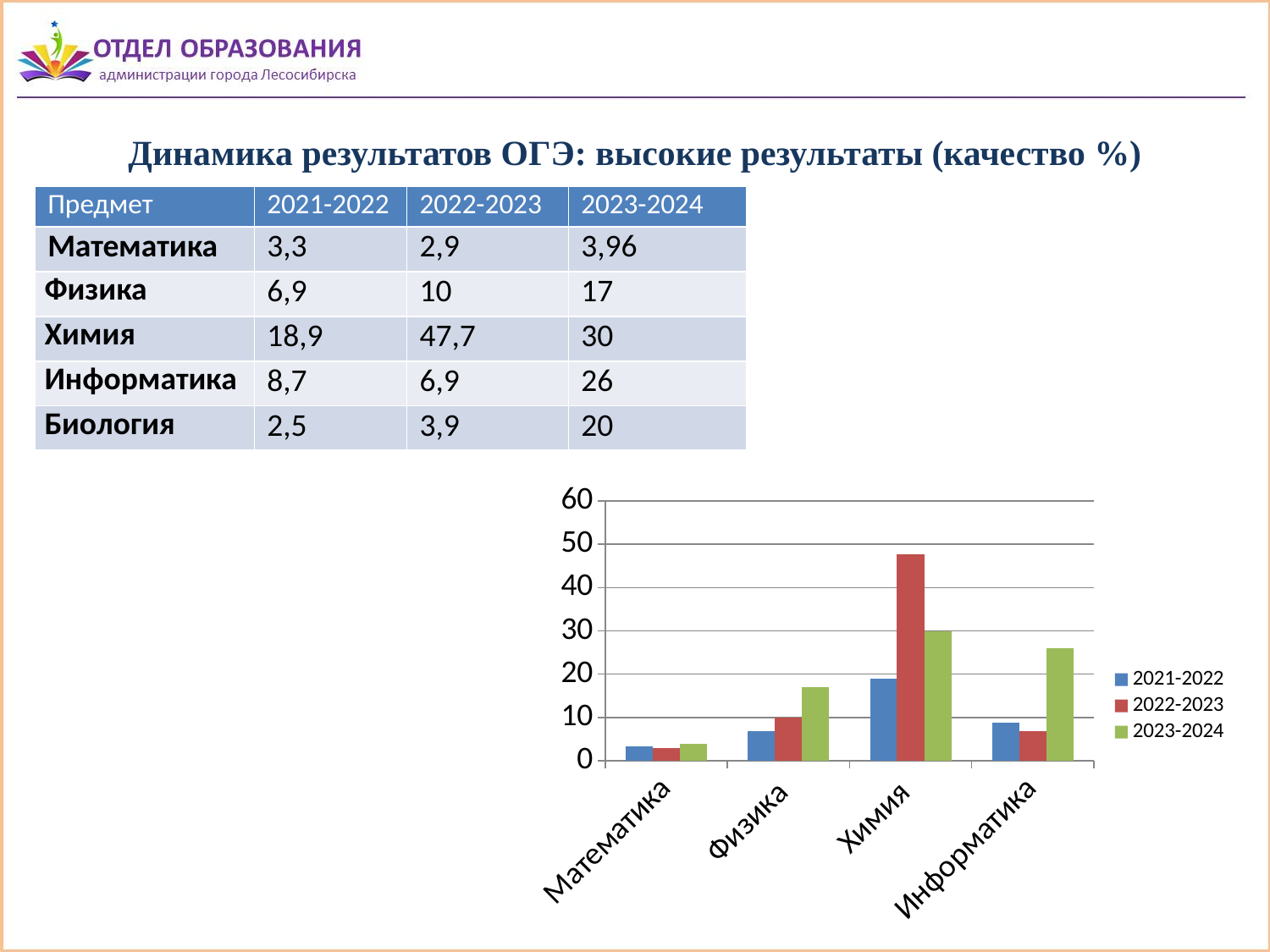
What kind of chart is shown on the slide? bar chart What is the value for Физика in the 2022-2023 series? 10 Which is larger in the 2021-2022 series: Химия or Физика? Химия How many series does the chart legend list? 3 Is the value for Математика in the 2023-2024 series greater or less than 10? less What are the three entries in the chart legend? 2021-2022, 2022-2023, 2023-2024 How many subject categories are plotted on the x axis of the chart? 4 Which subject has the highest value in the 2022-2023 series? Химия Which subject has the lowest value in the 2023-2024 series? Математика Do the values for Физика rise or fall from 2021-2022 to 2023-2024? rise What is the value for Химия in the 2023-2024 series? 30 Is the value for Информатика in the 2023-2024 series greater or less than 20? greater